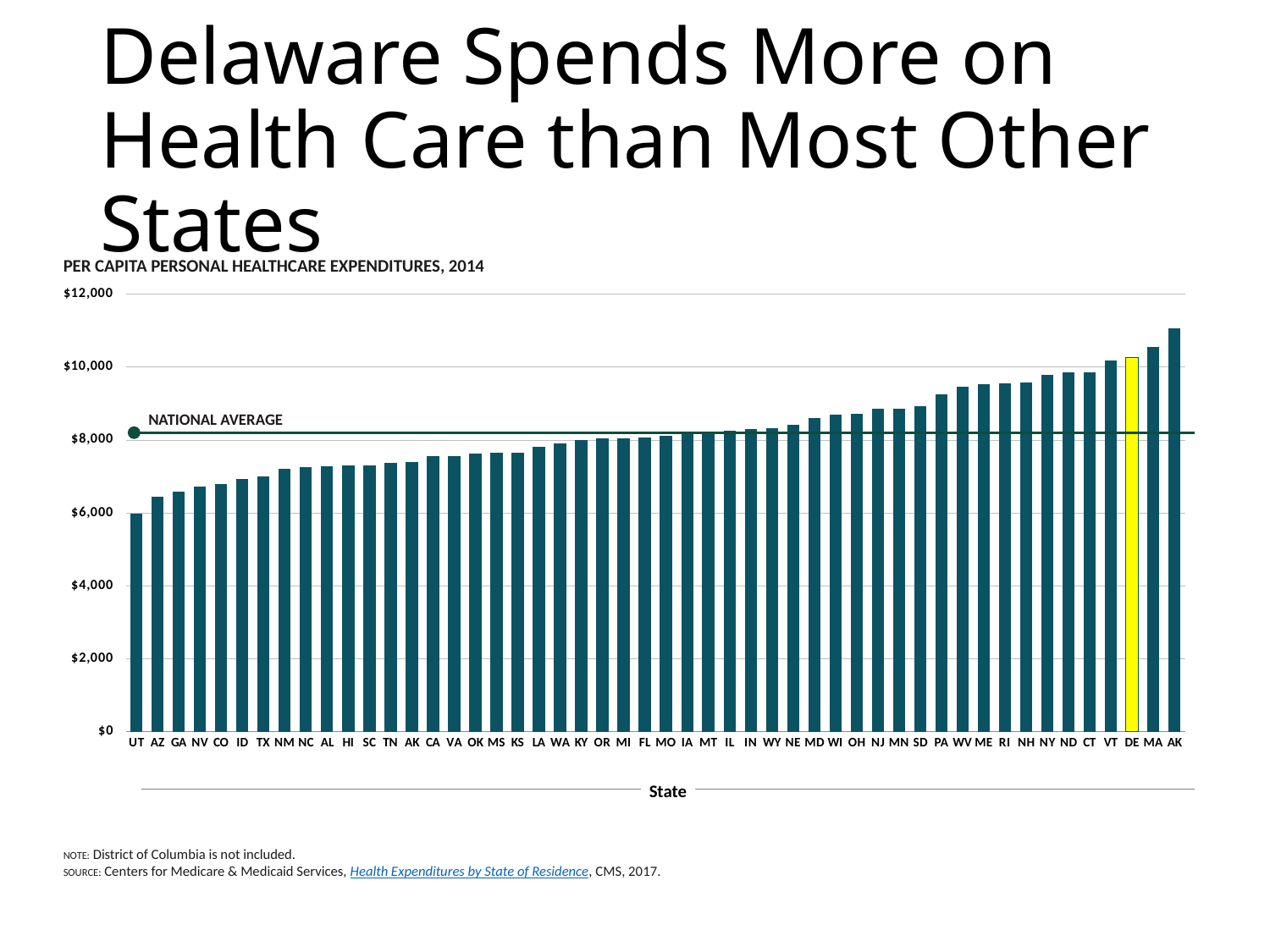
Do the bar values rise or fall moving from left to right along the x axis? rise Is the value for GA greater or less than $8,000? less Is the value for UT greater or less than $8,000? less Which state has the lowest per capita personal healthcare expenditure in the chart? UT Is the value for MA greater or less than $10,000? greater Which state has the highest per capita personal healthcare expenditure in the chart? AK Which state's bar is highlighted in yellow? DE Which has a higher per capita healthcare expenditure, DE or UT? DE What kind of chart is shown on the slide? bar chart How many states (bars) are shown in the chart? 50